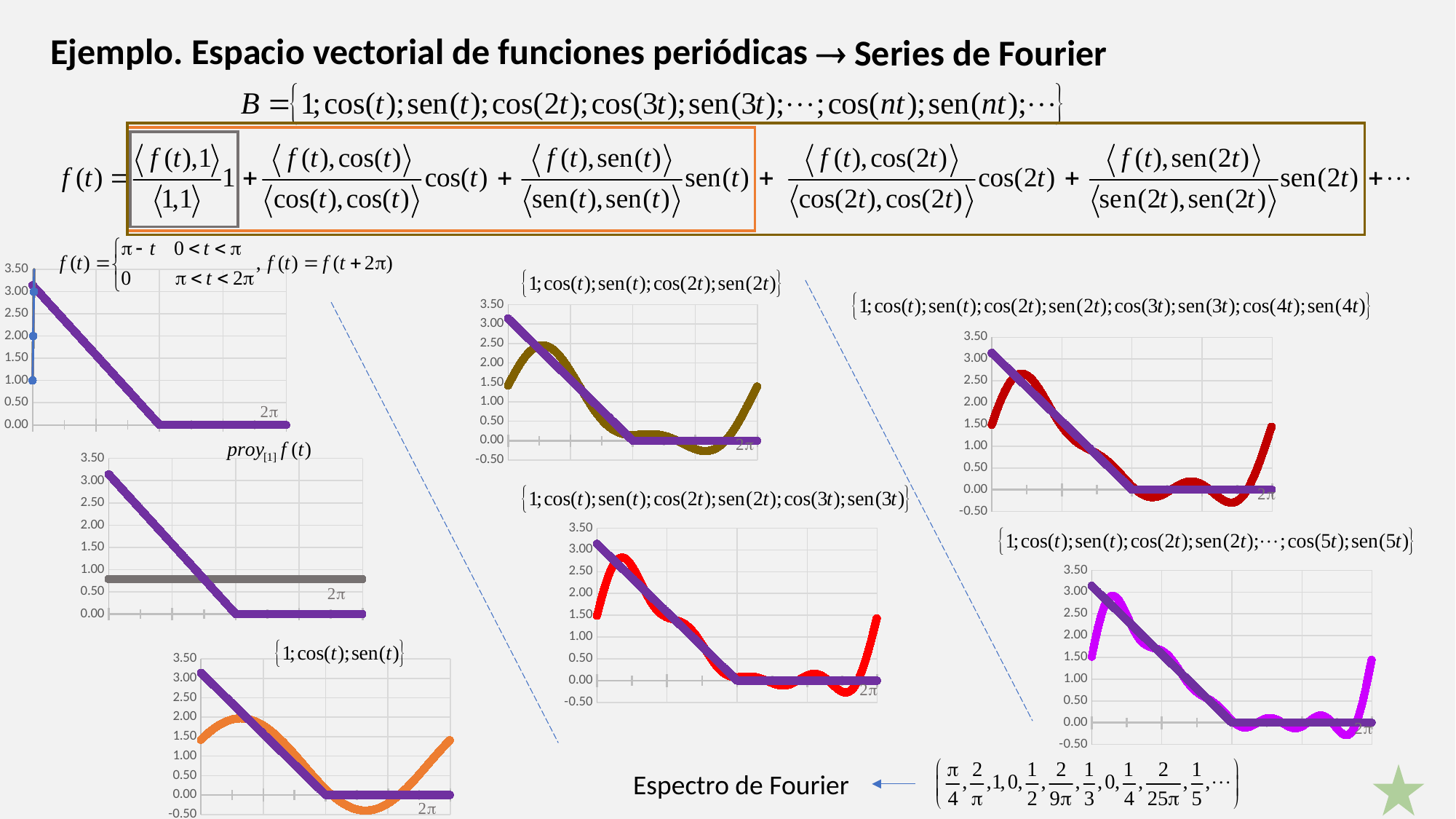
In the chart titled {1; cos(t); sen(t); cos(2t); sen(2t)}, is the value of the purple line at the right end of the x axis greater or less than 1.00? less In the chart titled {1; cos(t); sen(t)}, does the purple line rise or fall over the left half of the x axis? fall What kind of chart is used in the chart titled proy_[1] f(t)? line chart In the chart titled proy_[1] f(t), is the value of the gray horizontal line greater or less than 1.00? less In the chart titled {1; cos(t); sen(t)}, is the value of the orange curve at the left edge of the x axis greater or less than 1.00? greater How many charts are shown on the slide? 7 What label marks the right end of the x axis in the chart titled proy_[1] f(t)? 2π What is the lowest value shown on the vertical axis of the chart titled {1; cos(t); sen(t)}? -0.50 What is the highest value shown on the vertical axis of the chart titled {1; cos(t); sen(t)}? 3.50